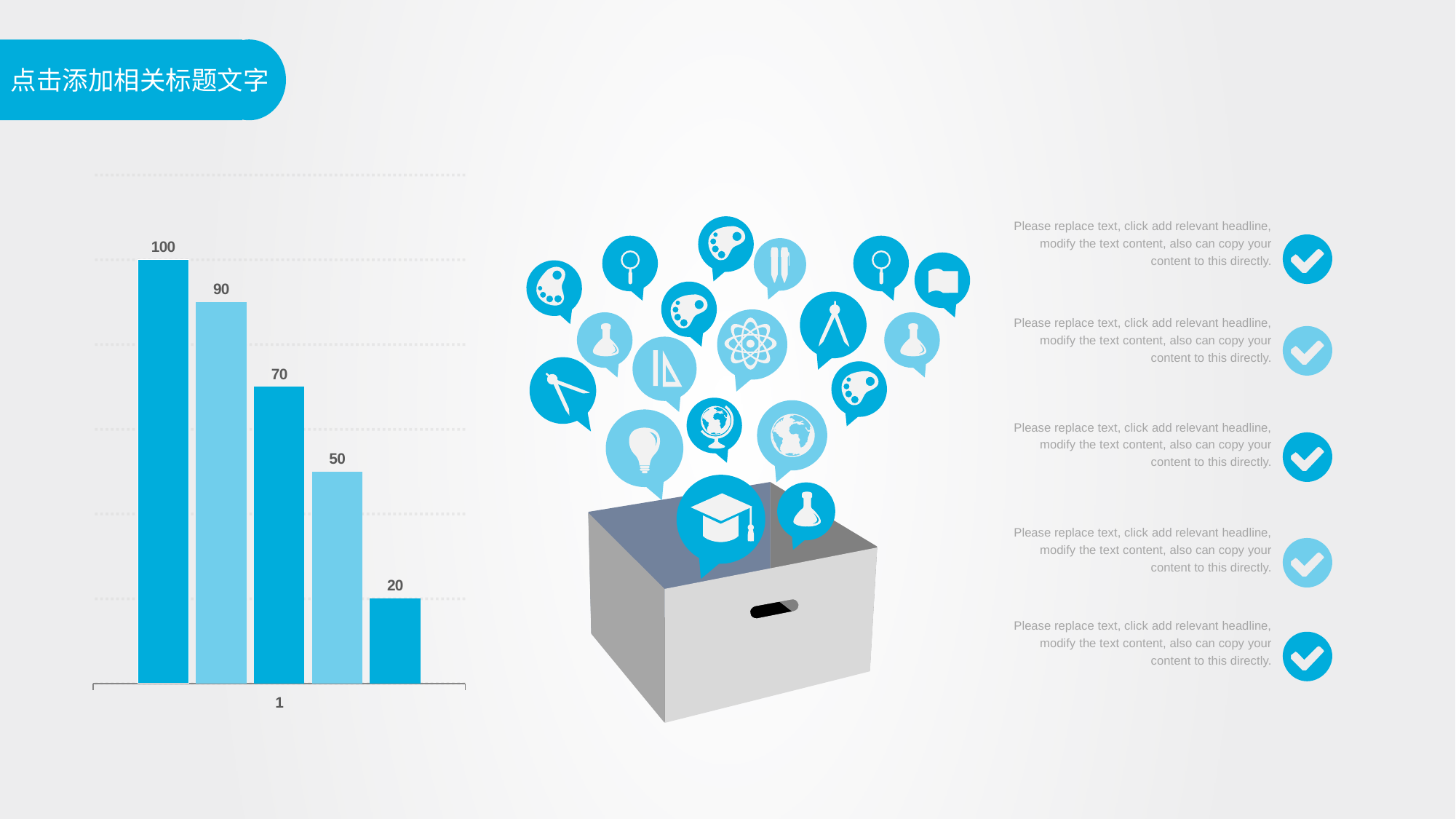
What is the difference between the second bar (90) and the fourth bar (50) in the chart? 40 What is the value of the second bar from the left in the chart? 90 Do the bar values rise or fall from left to right across the chart? fall What category label is shown on the x axis of the chart? 1 What is the difference between the tallest bar and the shortest bar in the chart? 80 What is the value of the shortest bar in the chart? 20 What is the value of the first (leftmost) bar in the chart? 100 What is the value of the rightmost bar in the chart? 20 What kind of chart is shown on the left of the slide? bar chart What is the value of the middle (third) bar in the chart? 70 How many bars does the chart show? 5 What is the value of the tallest bar in the chart? 100